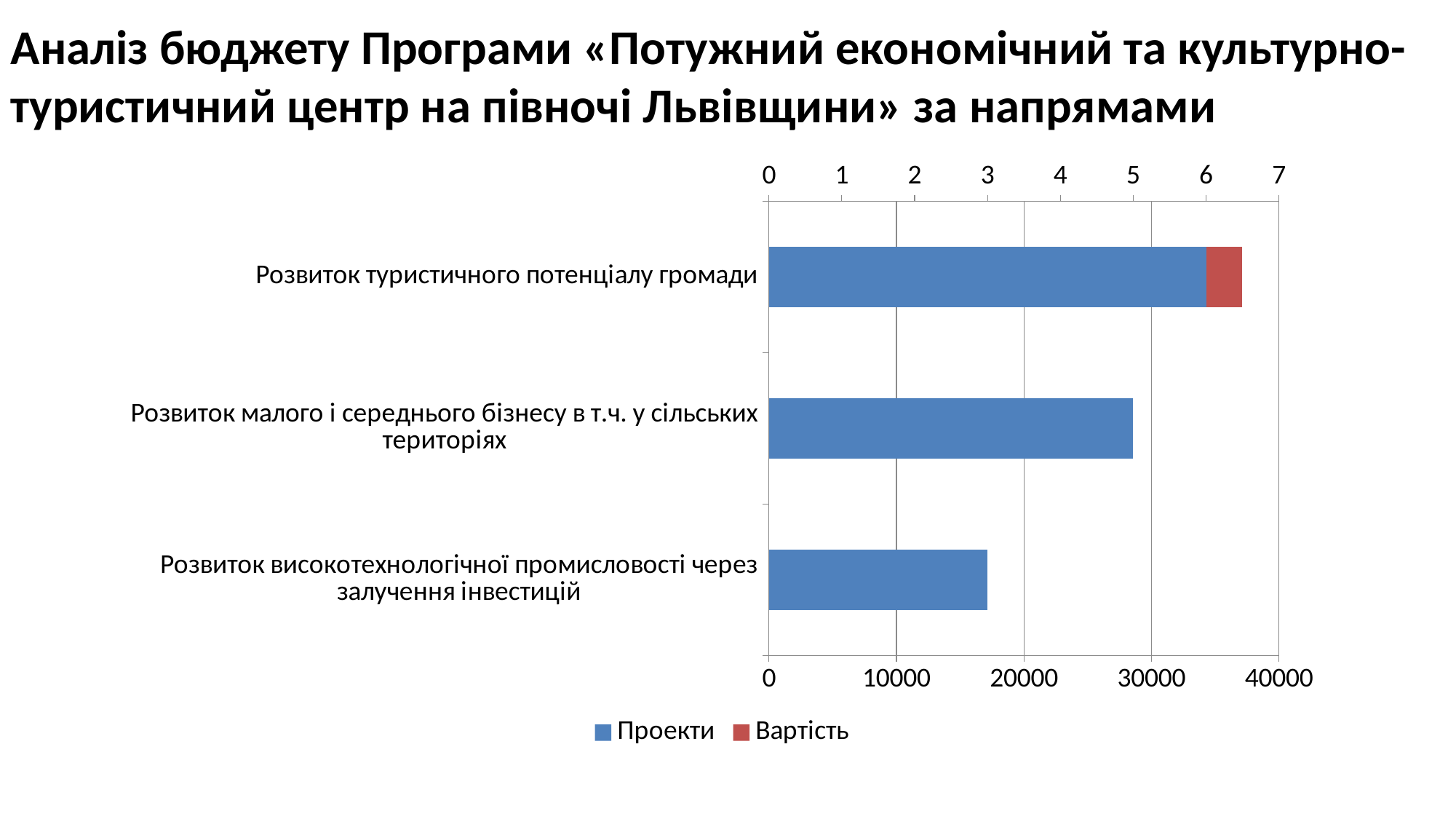
How many categories (directions) are shown on the chart? 3 What colour represents the Вартість series? red What are the two series named in the legend? Проекти, Вартість On the bottom axis, is the Вартість bar for Розвиток туристичного потенціалу громади greater or less than 30000? greater What kind of chart is shown on the slide? bar chart Which has the larger Проекти bar: Розвиток малого і середнього бізнесу or Розвиток високотехнологічної промисловості? Розвиток малого і середнього бізнесу On the top axis, what value does the Проекти bar for Розвиток високотехнологічної промисловості через залучення інвестицій reach? 3 On the top axis, what value does the Проекти bar for Розвиток малого і середнього бізнесу в т.ч. у сільських територіях reach? 5 How many series does the legend list? 2 Which category has the shortest Проекти bar? Розвиток високотехнологічної промисловості через залучення інвестицій On the top axis, what value does the Проекти bar for Розвиток туристичного потенціалу громади reach? 6 Which category has the longest Проекти bar? Розвиток туристичного потенціалу громади